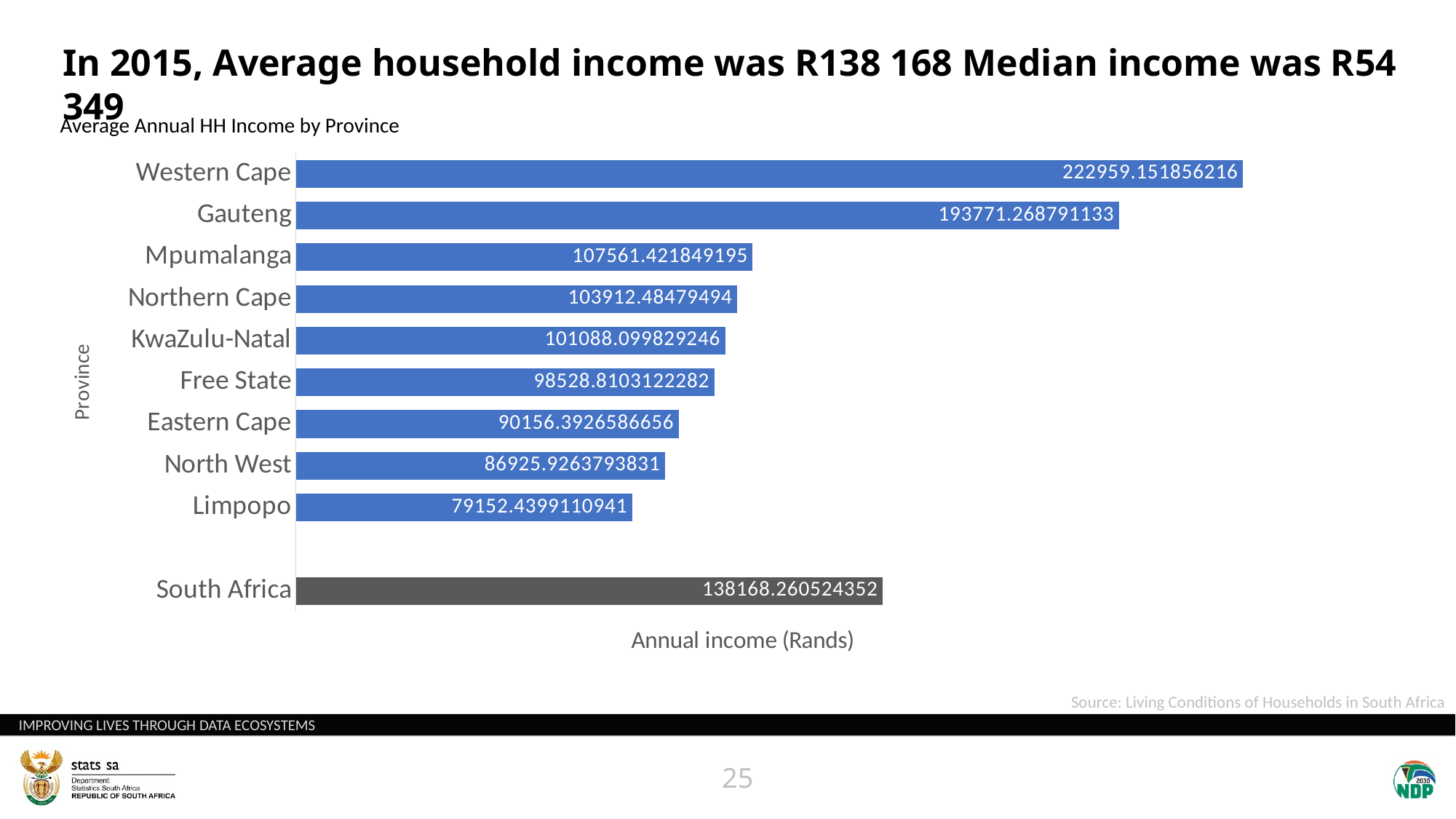
What is the average annual household income for Western Cape? 222959.151856216 What is the average annual household income for KwaZulu-Natal? 101088.099829246 What is the difference between the values for Western Cape and Gauteng? 29187.883065083 What type of chart is shown on the slide? Bar chart What is the average annual household income for Gauteng? 193771.268791133 Which has a higher average annual household income, Mpumalanga or Northern Cape? Mpumalanga How many bars are plotted in the chart? 10 What is the title of the horizontal axis? Annual income (Rands) What is the average annual household income for Limpopo? 79152.4399110941 Which province has the lowest average annual household income? Limpopo Which province has the highest average annual household income? Western Cape What is the value shown for South Africa? 138168.260524352